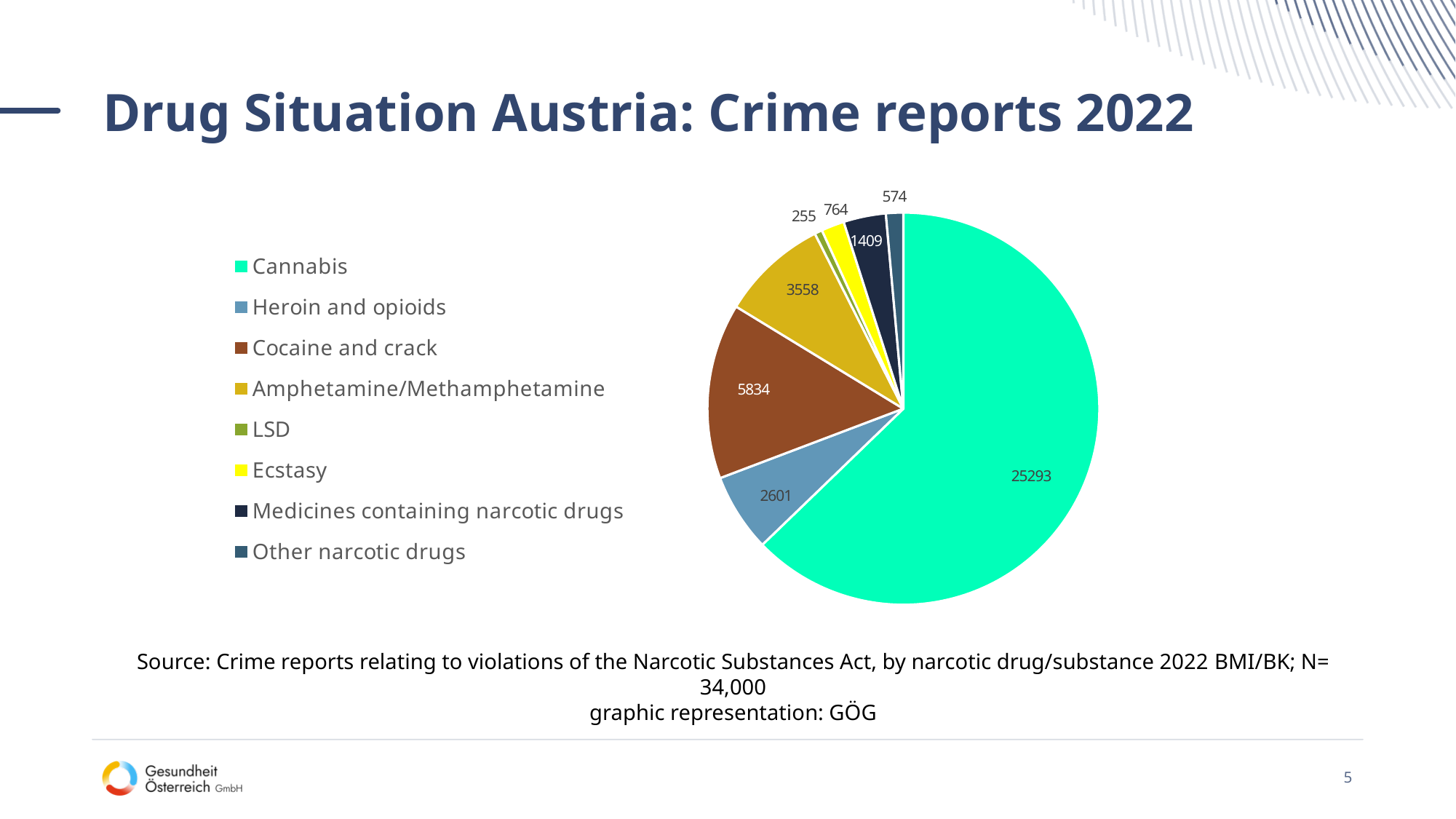
Which is larger, the value for Ecstasy or the value for Other narcotic drugs? Ecstasy What is the value for Amphetamine/Methamphetamine? 3558 How many crime reports are shown for Cannabis? 25293 What is the value for LSD? 255 Which category has the largest slice of the pie? Cannabis What type of chart is shown on the slide? Pie chart What is the difference between the values for Cocaine and crack and Heroin and opioids? 3233 What is the value for Cocaine and crack? 5834 Which category has the smallest slice of the pie? LSD What is the value for Heroin and opioids? 2601 What is the value for Medicines containing narcotic drugs? 1409 How many categories does the legend list? 8